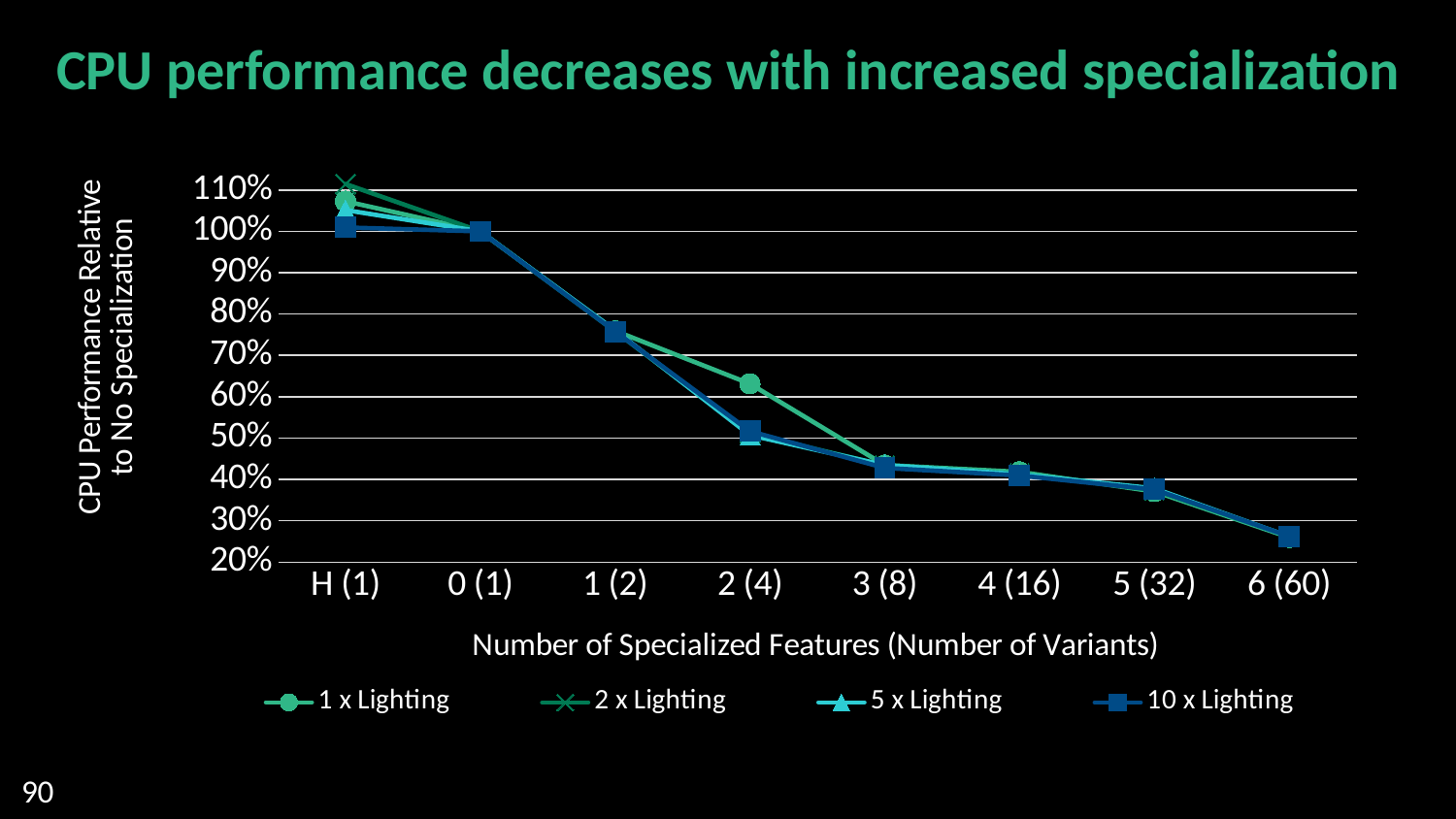
How many categories are shown on the x axis? 8 What kind of chart is shown on the slide? line chart What is the value for 10 x Lighting at 0 (1)? 100% Do the values generally rise or fall from 0 (1) to 6 (60) along the x axis? fall At 2 (4), which series has the larger value, 1 x Lighting or 10 x Lighting? 1 x Lighting Is the value for 1 x Lighting at 2 (4) greater or less than 60%? greater Which series has the highest value at H (1)? 2 x Lighting How many series does the legend list? 4 Is the value for 10 x Lighting at 5 (32) greater or less than 40%? less Is the value for 10 x Lighting at 6 (60) greater or less than 30%? less